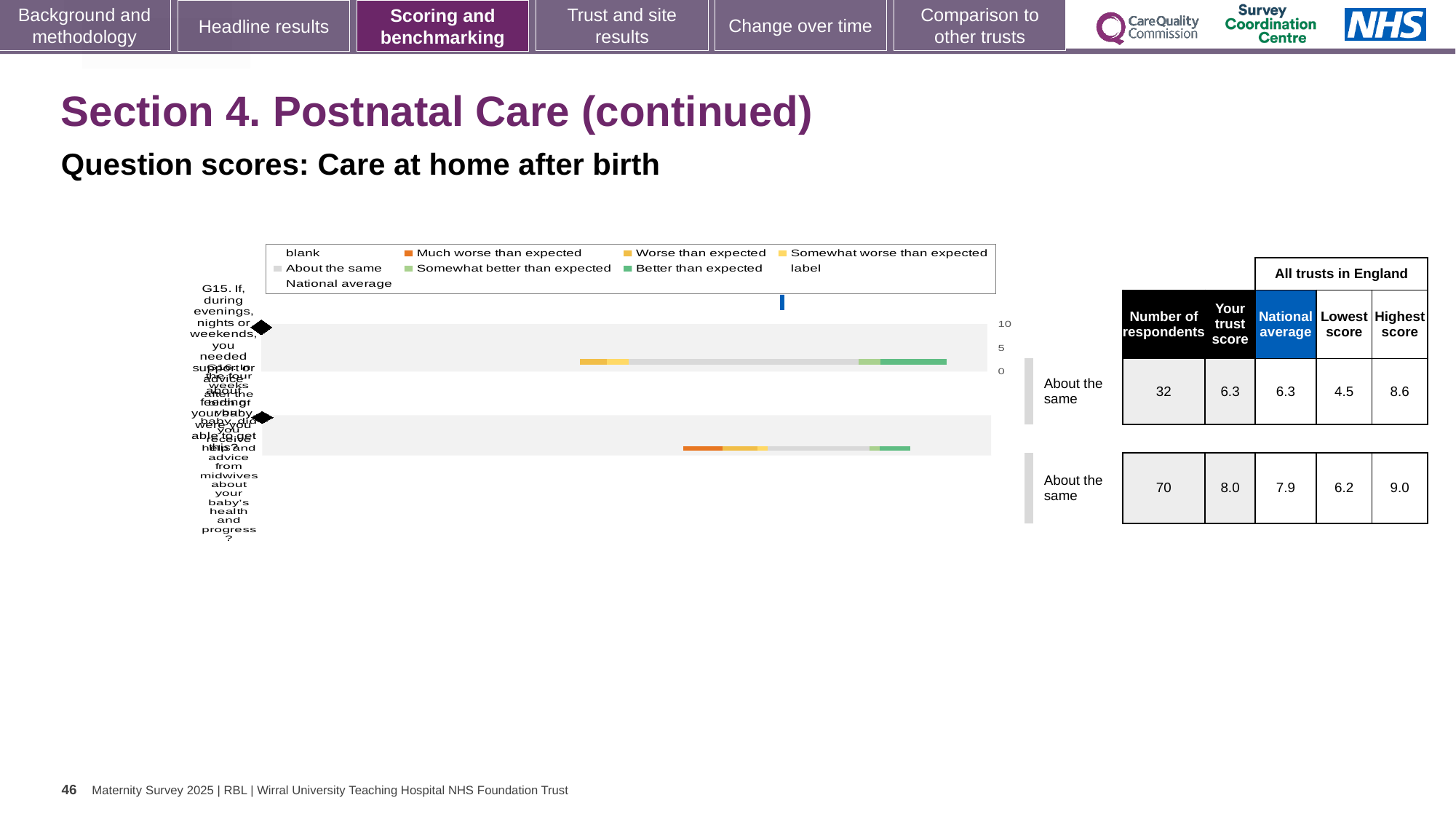
What is the difference between the trust scores of the second row (8.0) and the first row (6.3)? 1.7 What kind of chart is shown on the slide? bar chart What is the national average for the first (top) question row? 6.3 How many bars (question rows) does the chart show? 2 What is the highest score among all trusts in England for the second (bottom) question row? 9.0 What benchmark category is shown for both question rows? About the same What is the number of respondents for the second (bottom) question row? 70 What is the 'Your trust score' for the second (bottom) question row? 8.0 Which question row has the higher 'Your trust score', the first or the second? the second What is the difference between the highest score (8.6) and the lowest score (4.5) for the first question row? 4.1 What is the 'Your trust score' for the first (top) question row? 6.3 How many entries does the chart legend list? 9